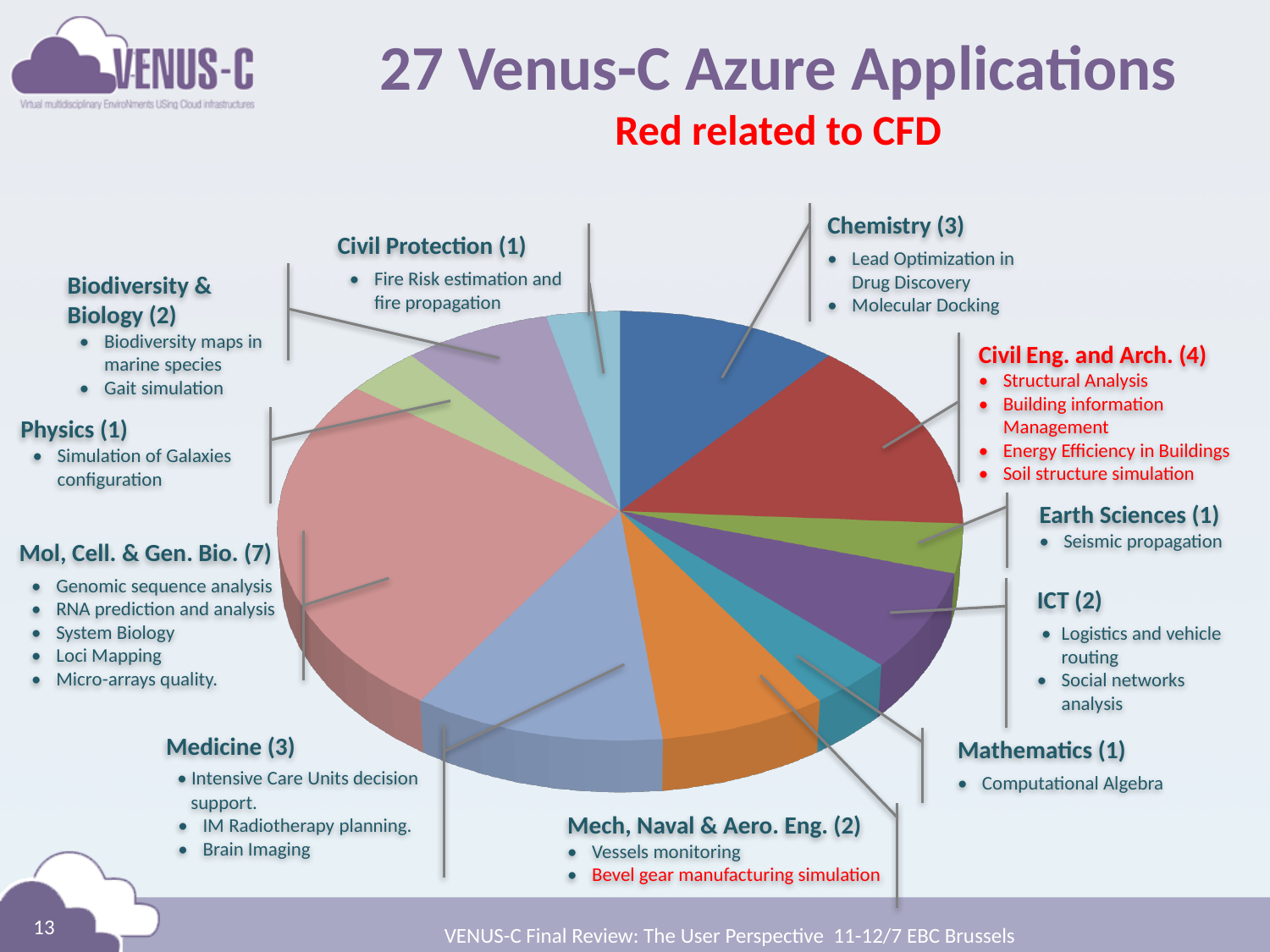
How many application areas (slices) does the pie chart show? 11 What is the total number of Venus-C Azure applications across all categories? 27 How many applications are in the Civil Eng. and Arch. category? 4 How many applications are in the ICT category? 2 According to the subtitle, what do the red-coloured labels indicate? Related to CFD What kind of chart is shown on the slide? pie chart How many applications are in the Chemistry category? 3 What is the difference between the number of applications in Mol, Cell. & Gen. Bio. and in Civil Eng. and Arch.? 3 Which application area has the most Venus-C Azure applications? Mol, Cell. & Gen. Bio. Which has more applications, Medicine or Mathematics? Medicine How many applications are in the Mol, Cell. & Gen. Bio. category? 7 Which has more applications, Chemistry or Earth Sciences? Chemistry